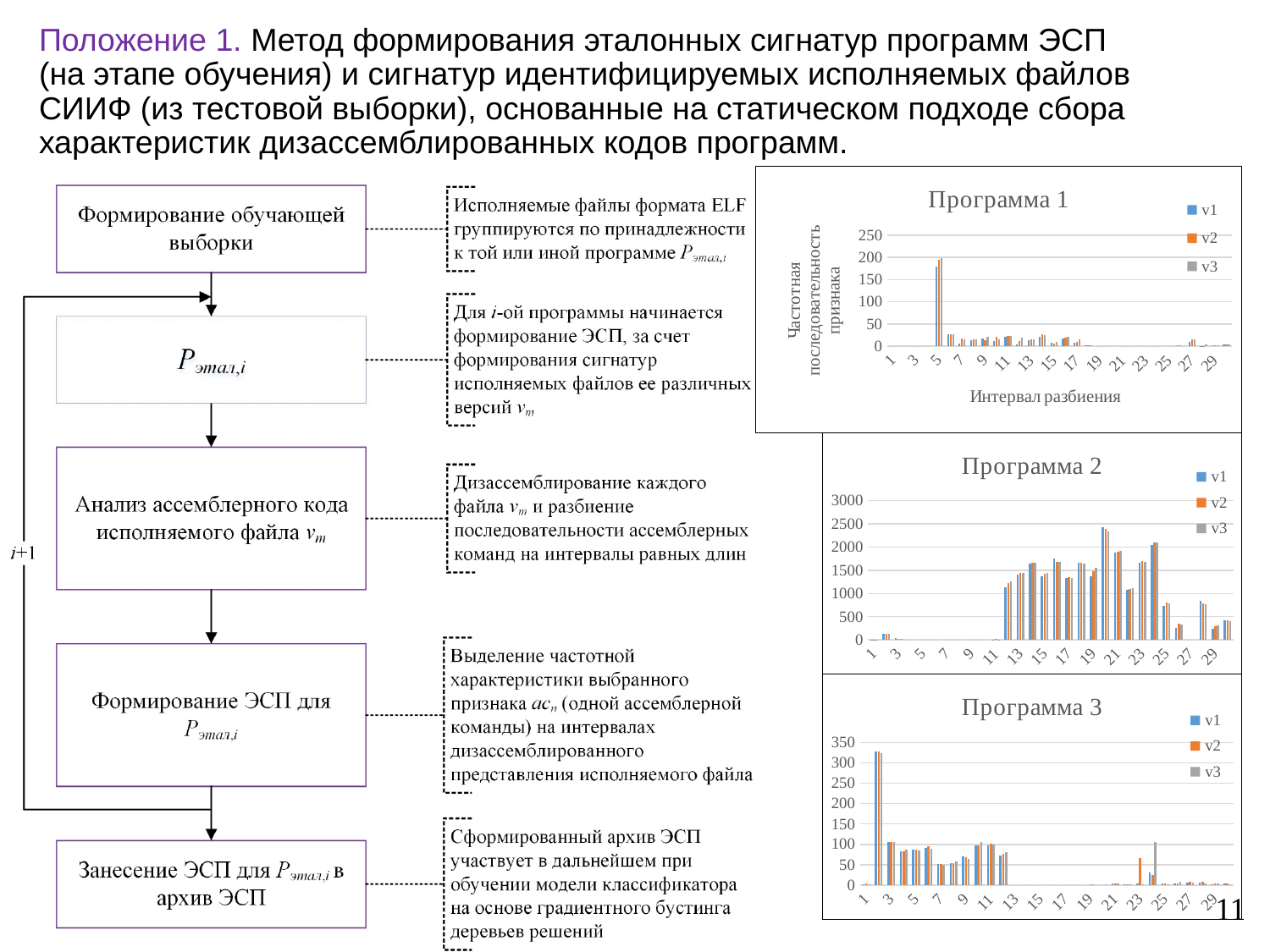
In the chart titled "Программа 3", is the value of v3 at interval 24 greater or less than 50? greater In the chart titled "Программа 1", at which interval does the tallest bar occur? 5 What are the legend entries of the chart titled "Программа 3"? v1, v2, v3 In the chart titled "Программа 1", is the value of v1 at interval 7 greater or less than 50? less In the chart titled "Программа 2", is the value of v1 at interval 20 greater or less than 2000? greater What is the x-axis title of the chart titled "Программа 1"? Интервал разбиения In the chart titled "Программа 3", at which interval does the tallest bar occur? 2 How many series does the legend of the chart titled "Программа 2" list? 3 What kind of chart is the chart titled "Программа 1"? bar chart